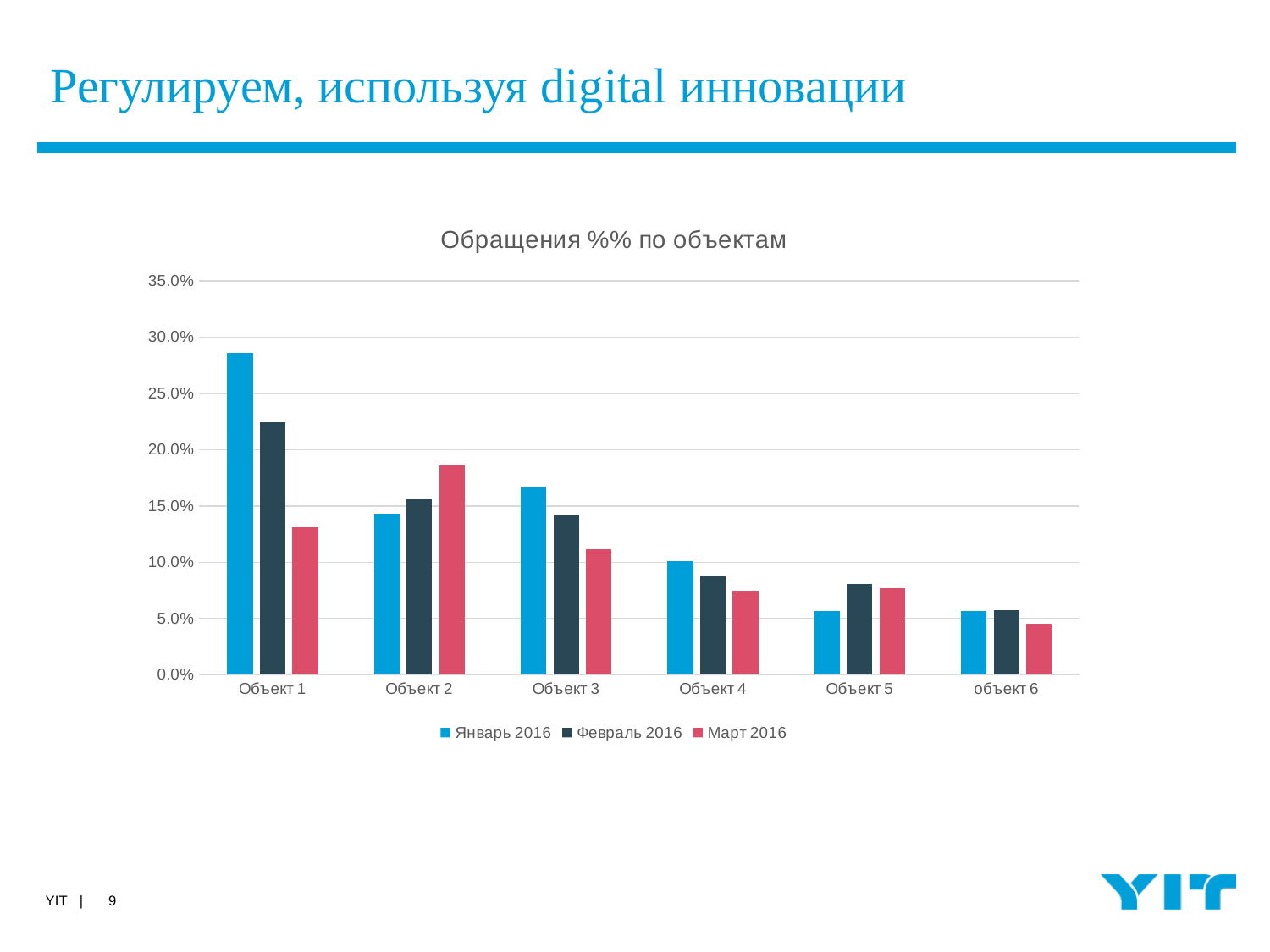
Which object has the highest value for Январь 2016? Объект 1 How many series does the legend list? 3 Which object has the lowest value for Март 2016? объект 6 Which series is shown in red in the legend? Март 2016 For Объект 3, which is larger: the Январь 2016 value or the Март 2016 value? Январь 2016 For Объект 1, do the values rise or fall from Январь 2016 to Март 2016? fall How many categories (objects) are shown on the x axis? 6 What is the title of the chart? Обращения %% по объектам Is the value for Объект 1 in Январь 2016 greater or less than 25.0%? greater What kind of chart is shown on the slide? bar chart For Объект 2, which is larger: the Январь 2016 value or the Март 2016 value? Март 2016 Is the value for Объект 4 in Март 2016 greater or less than 10.0%? less